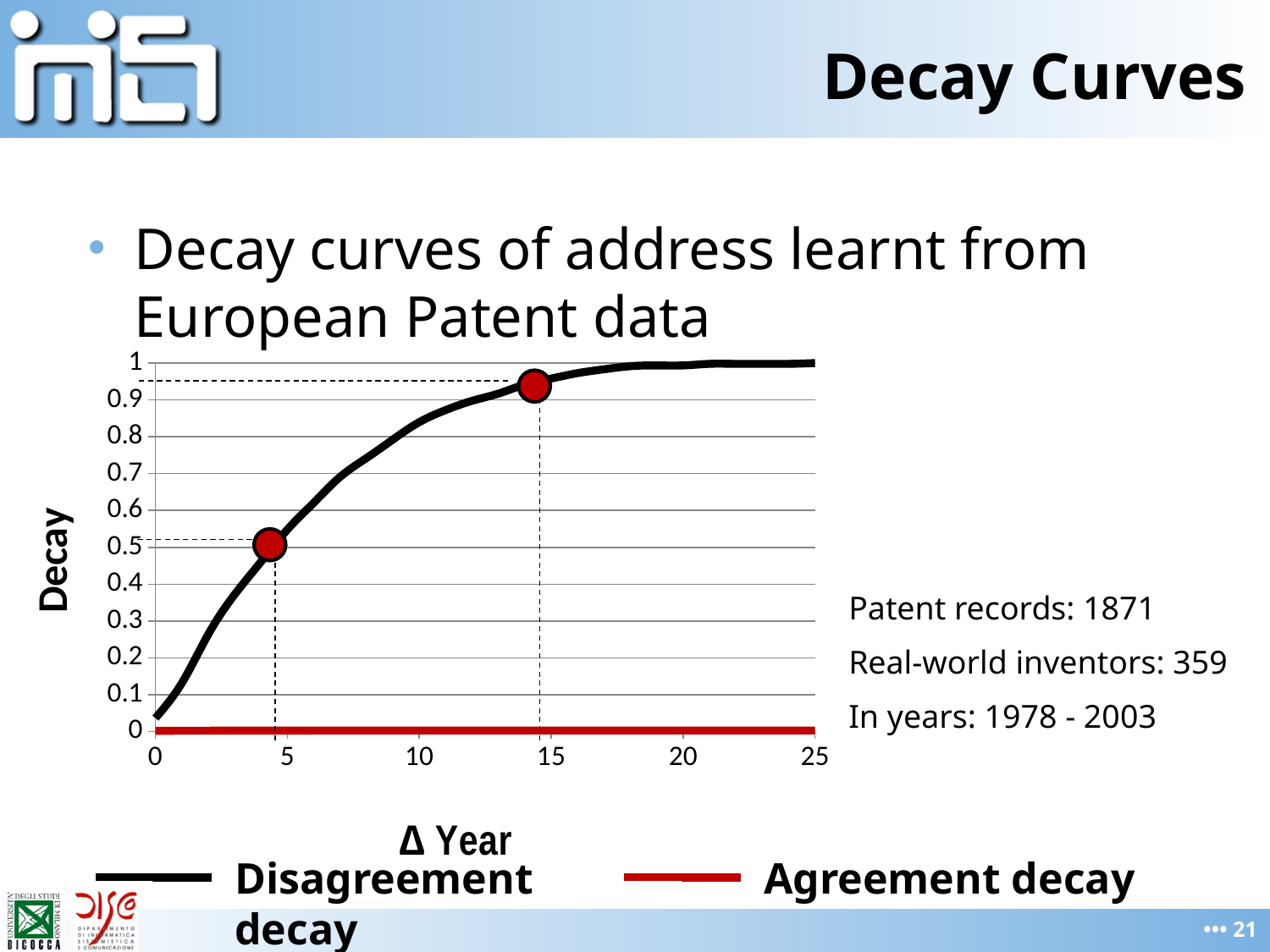
Is the value of the Disagreement decay curve at Δ Year 10 greater or less than 0.7? greater Is the value of the Disagreement decay curve at Δ Year 2 greater or less than 0.5? less Is the value of the Disagreement decay curve at Δ Year 20 greater or less than 0.9? greater What is the label of the x axis of the chart? Δ Year At Δ Year 15, which series has the larger value, Disagreement decay or Agreement decay? Disagreement decay What is the highest value shown on the y axis of the chart? 1 What is the label of the y axis of the chart? Decay How many series does the chart legend list? 2 What kind of chart is shown on the slide? line chart Does the Disagreement decay curve rise or fall as Δ Year increases? rise